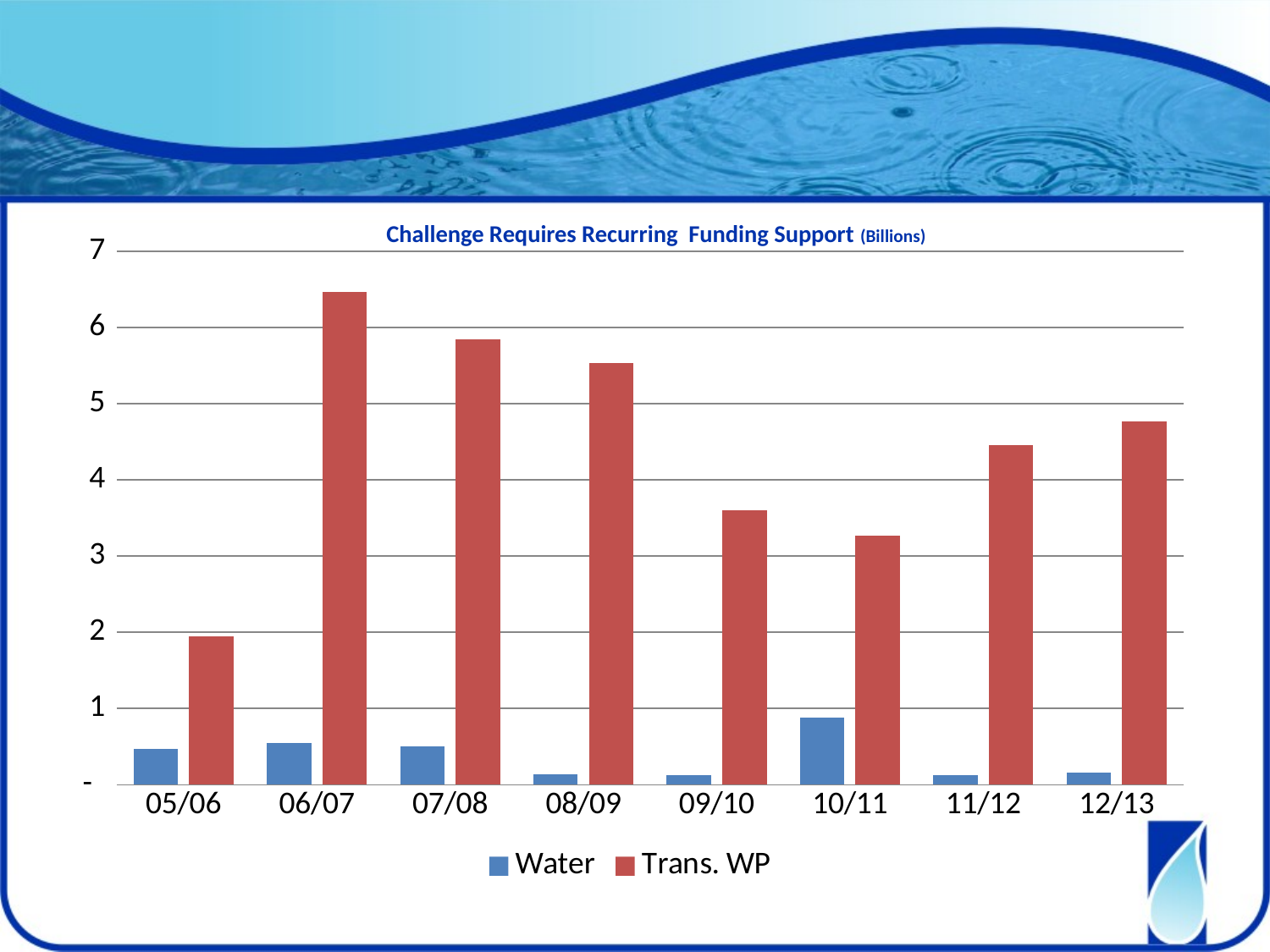
How many fiscal-year categories are shown on the x axis? 8 Which is larger, the Trans. WP value for 06/07 or for 12/13? 06/07 What kind of chart is shown on the slide? bar chart Which year has the highest Trans. WP value? 06/07 Is the Trans. WP value for 12/13 greater or less than 5? less Which year has the highest Water value? 10/11 Which year has the lowest Trans. WP value? 05/06 What unit is given in parentheses in the chart title? Billions Is the Water value for 10/11 greater or less than 1? less How many series does the legend list? 2 Is the Trans. WP value for 06/07 greater or less than 6? greater